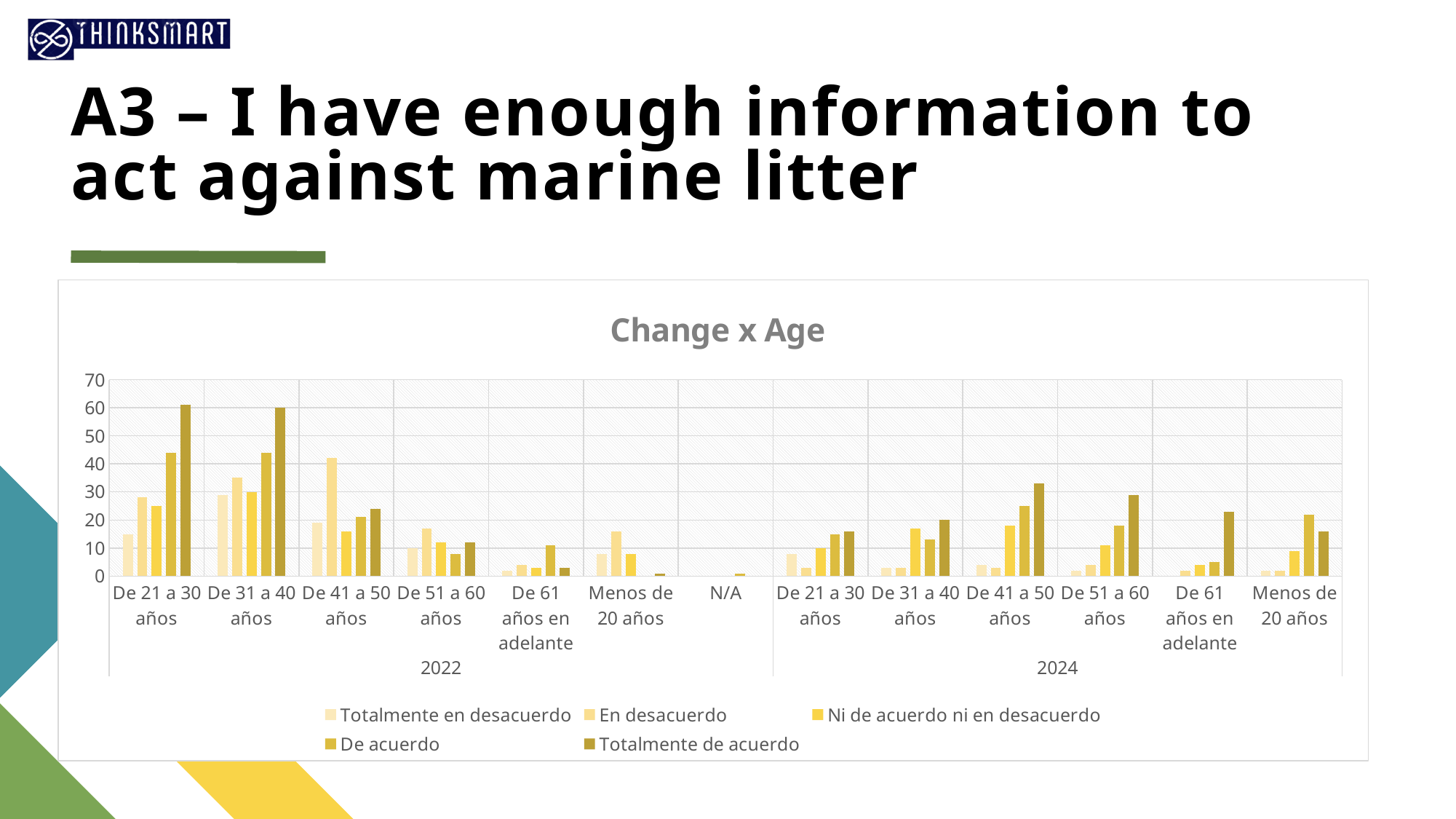
How many age-group categories are shown under 2024 on the x axis? 6 Is the value of 'Totalmente de acuerdo' for 'De 21 a 30 años' in 2022 greater or less than 50? greater For 'De 21 a 30 años', is the 'Totalmente de acuerdo' value larger in 2022 or in 2024? 2022 How many age-group categories are shown under 2022 on the x axis? 7 What is the title of the chart? Change x Age What kind of chart is shown on the slide? bar chart Is the value of 'Totalmente de acuerdo' for 'De 41 a 50 años' in 2024 greater or less than 40? less Which age group has the highest 'Totalmente de acuerdo' value in 2024? De 41 a 50 años Is the value of 'En desacuerdo' for 'De 41 a 50 años' in 2022 greater or less than 30? greater Which two years are compared on the x axis of the chart? 2022 and 2024 How many series does the chart legend list? 5